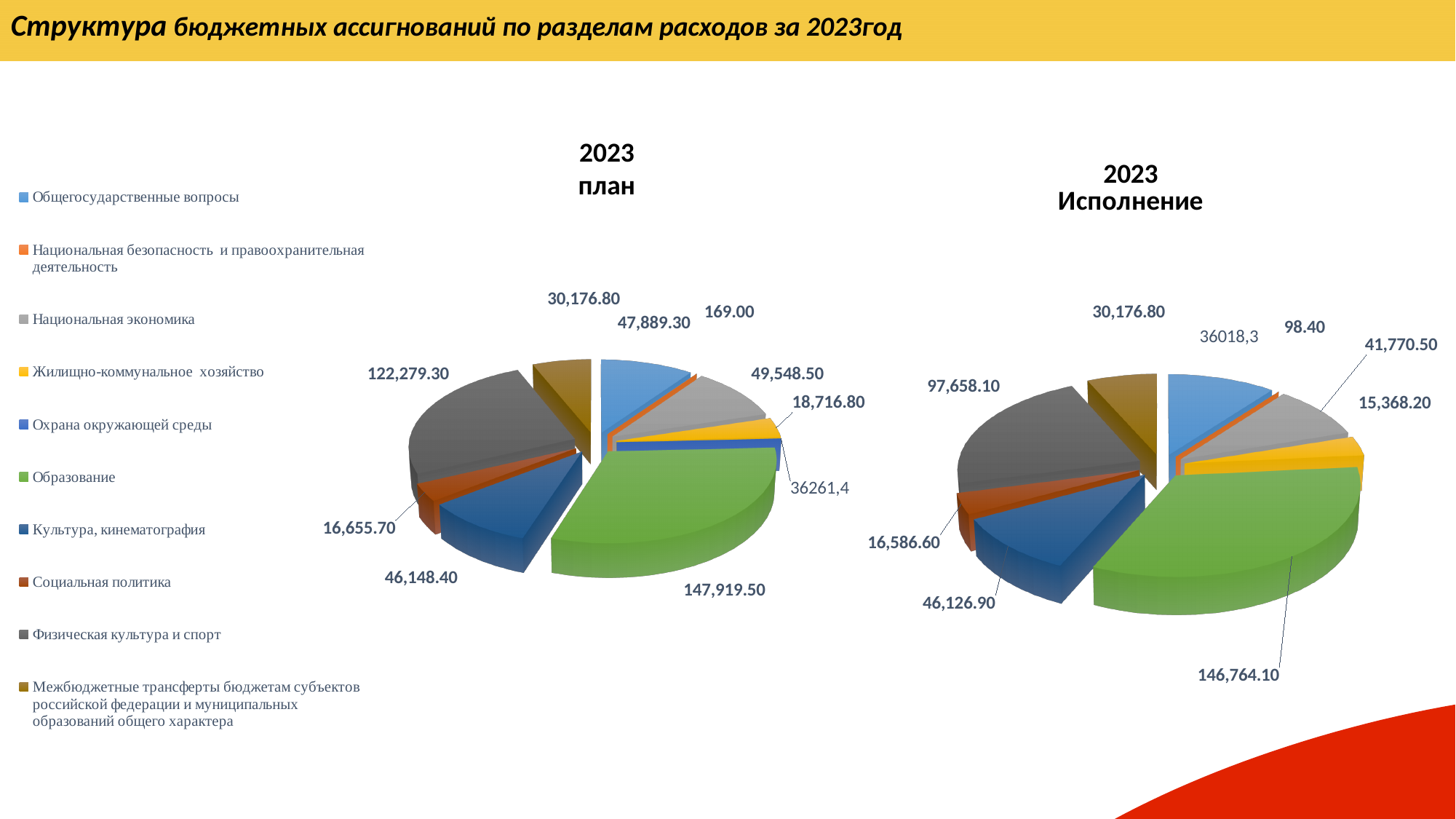
Is the value for Образование larger in the '2023 план' chart or in the '2023 Исполнение' chart? 2023 план In the '2023 Исполнение' chart, what is the value for Физическая культура и спорт? 97,658.10 What is the difference between the Физическая культура и спорт value in the '2023 план' chart and in the '2023 Исполнение' chart? 24,621.20 What kind of charts are shown on the slide? Pie charts In the '2023 план' chart, which category has the largest slice? Образование In the '2023 Исполнение' chart, what is the value for Национальная безопасность и правоохранительная деятельность? 98.40 How many categories does the legend list? 10 In the '2023 план' chart, what is the value for Образование? 147,919.50 In the '2023 Исполнение' chart, what is the value for Культура, кинематография? 46,126.90 In the '2023 план' chart, what is the value for Физическая культура и спорт? 122,279.30 In the '2023 Исполнение' chart, what is the value for Образование? 146,764.10